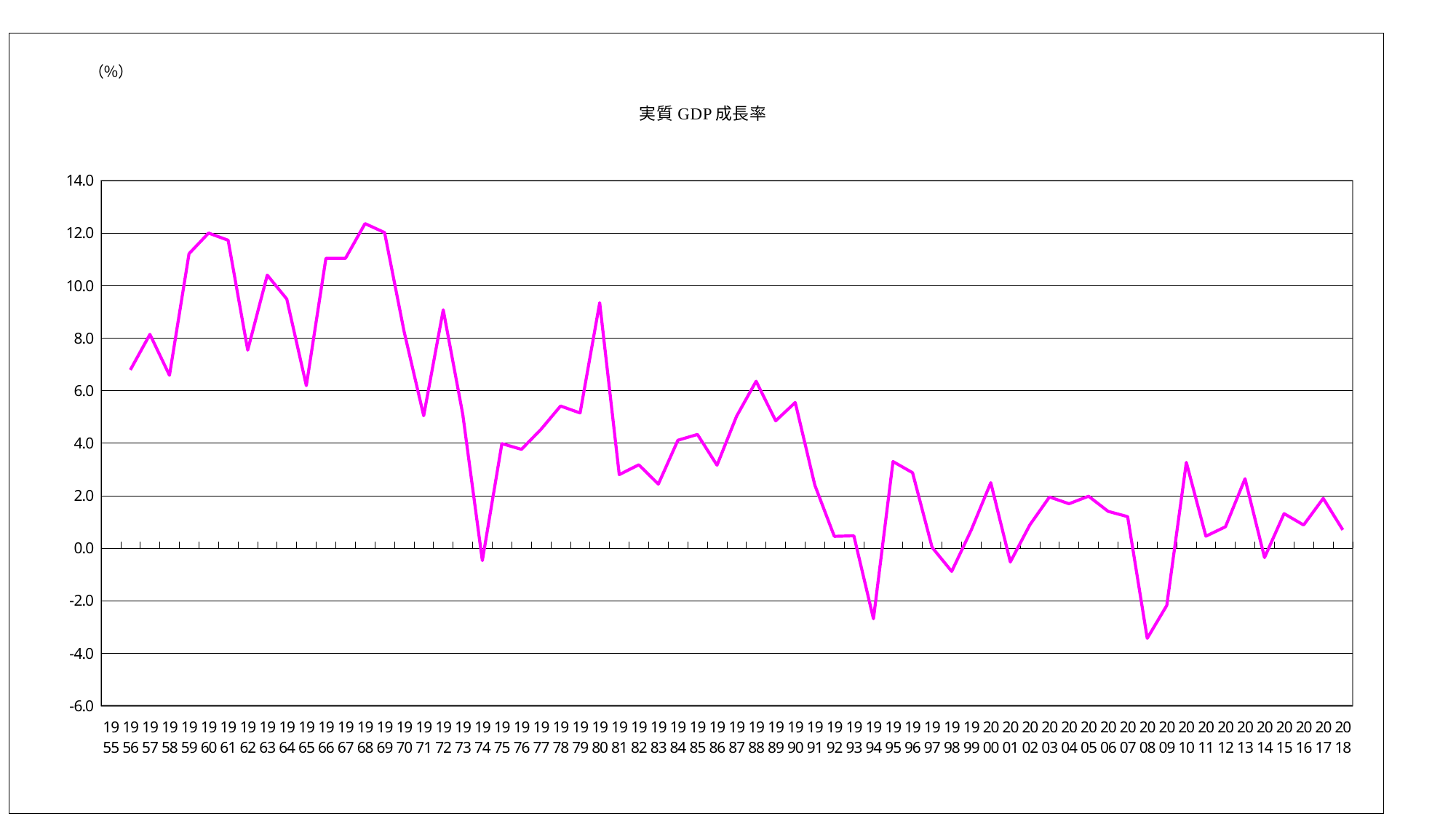
Overall, does the real GDP growth rate rise or fall from 1955 to 2018? fall Is the value for 1974 greater or less than 0.0? less Is the value for 2010 greater or less than 2.0? greater Which year has the higher real GDP growth rate, 1980 or 1981? 1980 What kind of chart is shown on the slide? line chart What unit is indicated at the top left of the chart? (%) How many years (data points) are plotted along the x axis? 64 Is the value for 1968 greater or less than 12.0? greater Which year has the lowest real GDP growth rate on the chart? 2008 What is the title of the chart? 実質GDP成長率